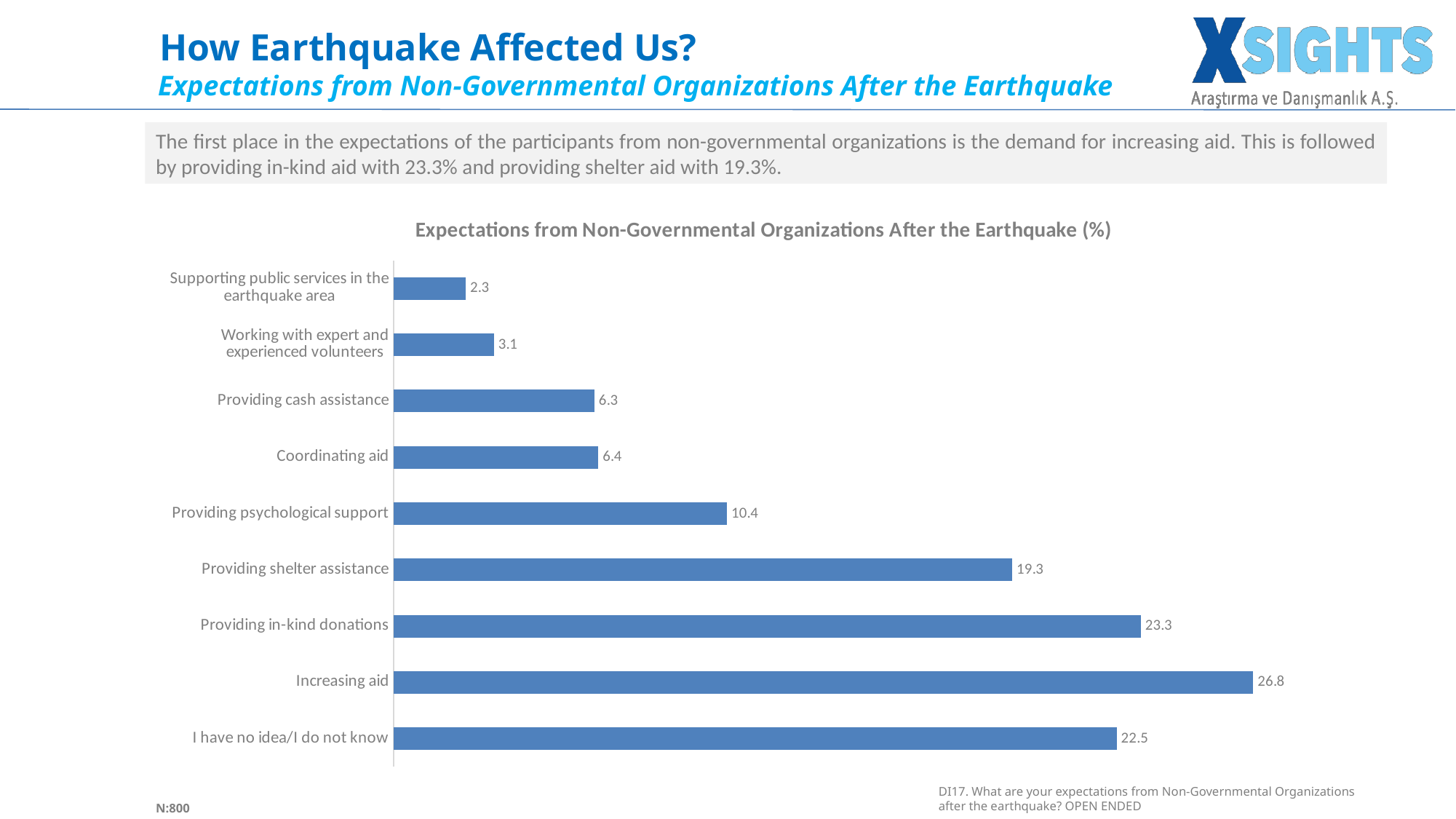
What is the value for Working with expert and experienced volunteers? 3.1 What is the title of the chart? Expectations from Non-Governmental Organizations After the Earthquake (%) What is the value for Supporting public services in the earthquake area? 2.3 What kind of chart is shown on the slide? Bar chart What is the difference between the values for Coordinating aid and Providing cash assistance? 0.1 What is the difference between the values for Providing in-kind donations and Providing shelter assistance? 4.0 Which is larger, the value for Increasing aid or the value for I have no idea/I do not know? Increasing aid What is the value for Increasing aid? 26.8 How many categories are shown in the chart? 9 What is the value for Providing psychological support? 10.4 Which category has the highest value? Increasing aid Which category has the lowest value? Supporting public services in the earthquake area